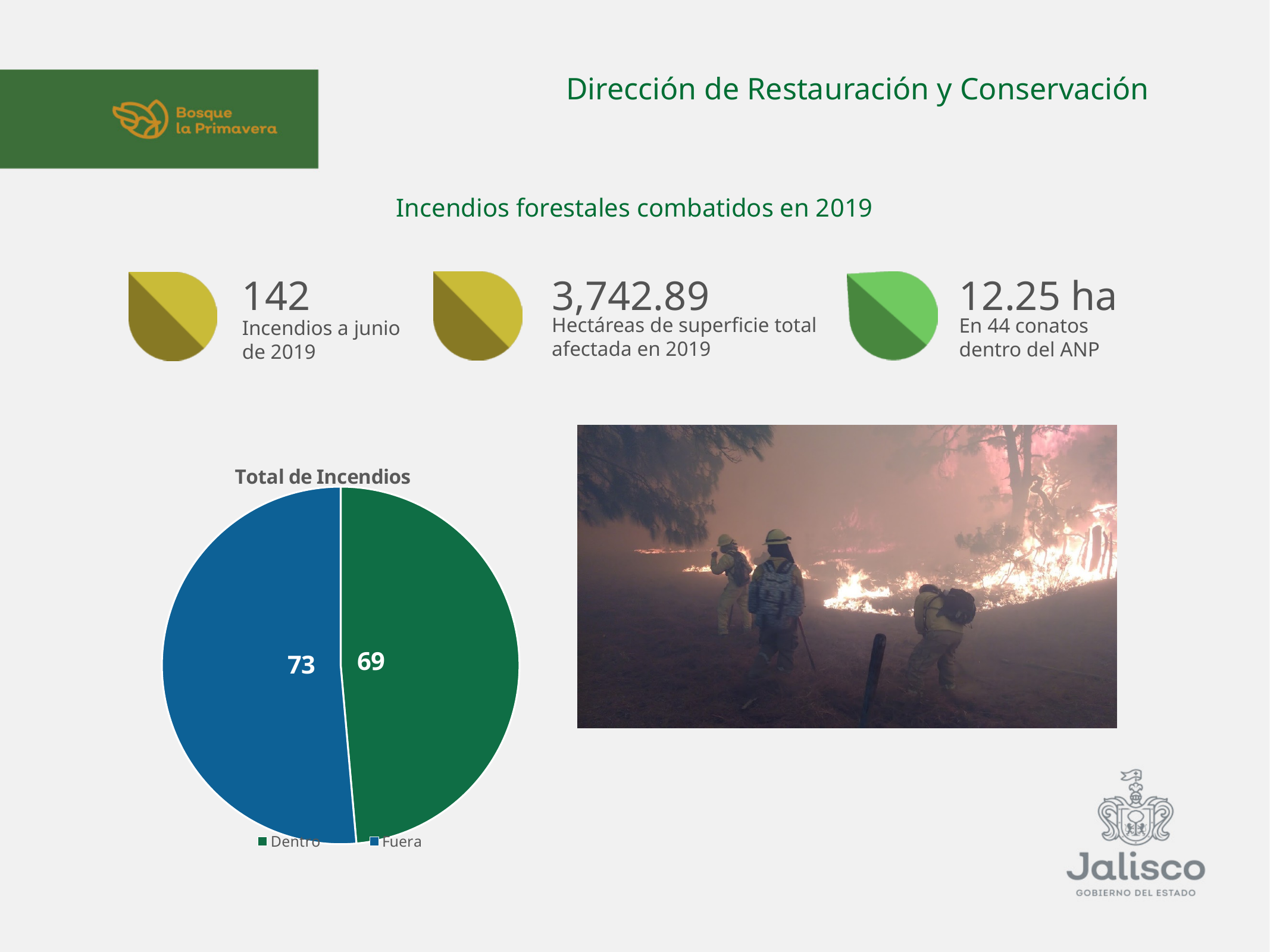
How many entries does the legend of the "Total de Incendios" pie chart list? 2 What is the total of the two slices in the "Total de Incendios" pie chart? 142 In the "Total de Incendios" pie chart, which category has the larger value? Fuera In the "Total de Incendios" pie chart, what is the value for Dentro? 69 In the "Total de Incendios" pie chart, which category has the smaller value? Dentro What type of chart is "Total de Incendios"? pie chart In the "Total de Incendios" pie chart, what is the difference between the Fuera and Dentro values? 4 In the "Total de Incendios" pie chart, what colour is the Fuera slice? blue In the "Total de Incendios" pie chart, is the value for Dentro larger or smaller than the value for Fuera? smaller How many slices does the "Total de Incendios" pie chart have? 2 In the "Total de Incendios" pie chart, what is the value for Fuera? 73 What is the title of the pie chart on the slide? Total de Incendios